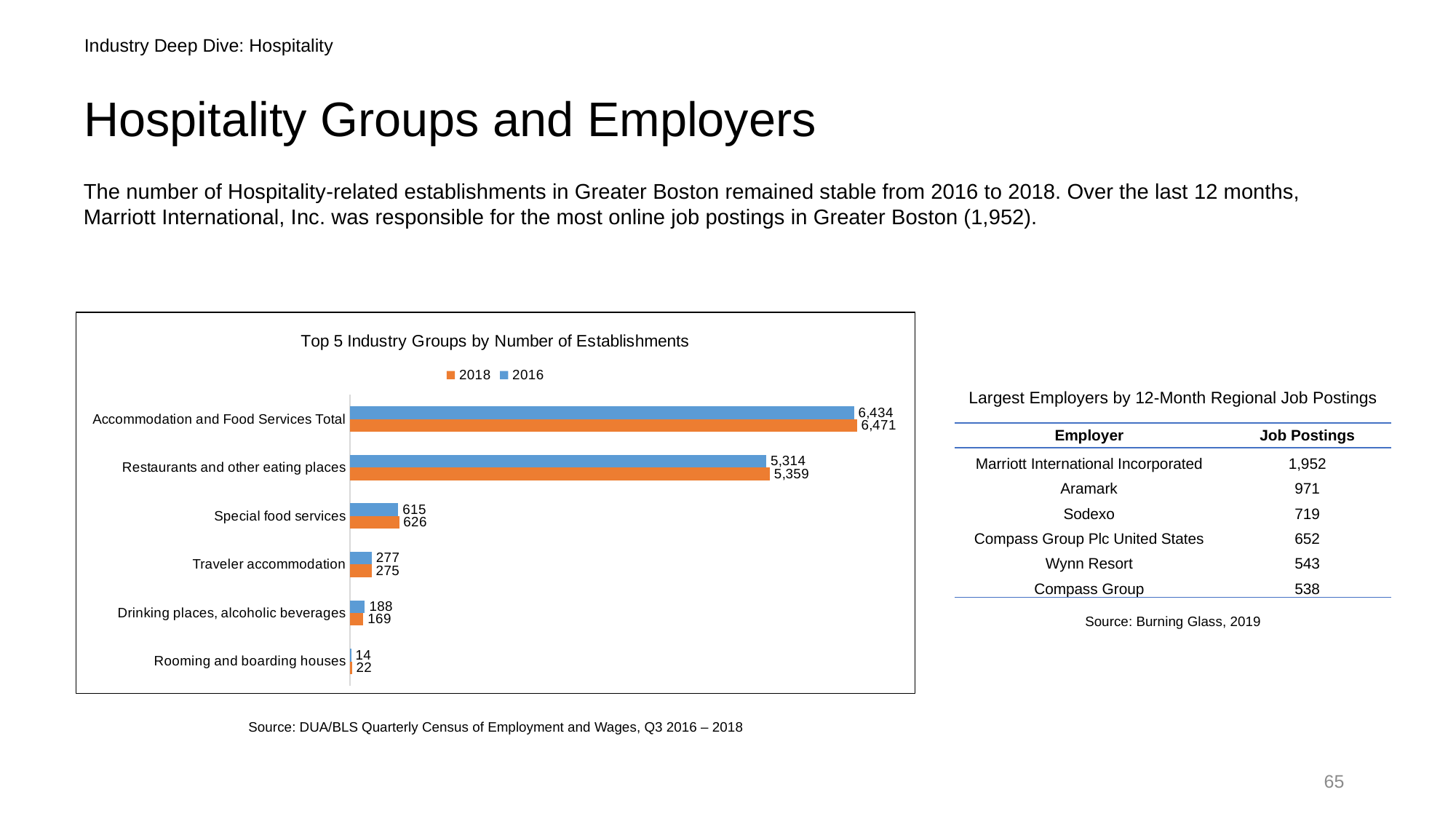
In the 'Top 5 Industry Groups by Number of Establishments' chart, is the 2016 value for Traveler accommodation larger or smaller than the 2016 value for Drinking places, alcoholic beverages? Larger In the 'Top 5 Industry Groups by Number of Establishments' chart, what is the 2016 value for Special food services? 615 In the 'Top 5 Industry Groups by Number of Establishments' chart, what is the difference between the 2018 and 2016 values for Accommodation and Food Services Total? 37 In the 'Top 5 Industry Groups by Number of Establishments' chart, which colour represents the 2018 series? Orange In the 'Top 5 Industry Groups by Number of Establishments' chart, what is the difference between the 2016 and 2018 values for Drinking places, alcoholic beverages? 19 How many series does the legend of the 'Top 5 Industry Groups by Number of Establishments' chart list? 2 In the 'Top 5 Industry Groups by Number of Establishments' chart, what is the 2018 value for Rooming and boarding houses? 22 How many industry group categories are plotted in the 'Top 5 Industry Groups by Number of Establishments' chart? 6 In the 'Top 5 Industry Groups by Number of Establishments' chart, what is the 2018 value for Restaurants and other eating places? 5,359 In the 'Top 5 Industry Groups by Number of Establishments' chart, which category has the highest 2018 value? Accommodation and Food Services Total What type of chart is 'Top 5 Industry Groups by Number of Establishments'? Bar chart In the 'Top 5 Industry Groups by Number of Establishments' chart, which category has the lowest 2016 value? Rooming and boarding houses